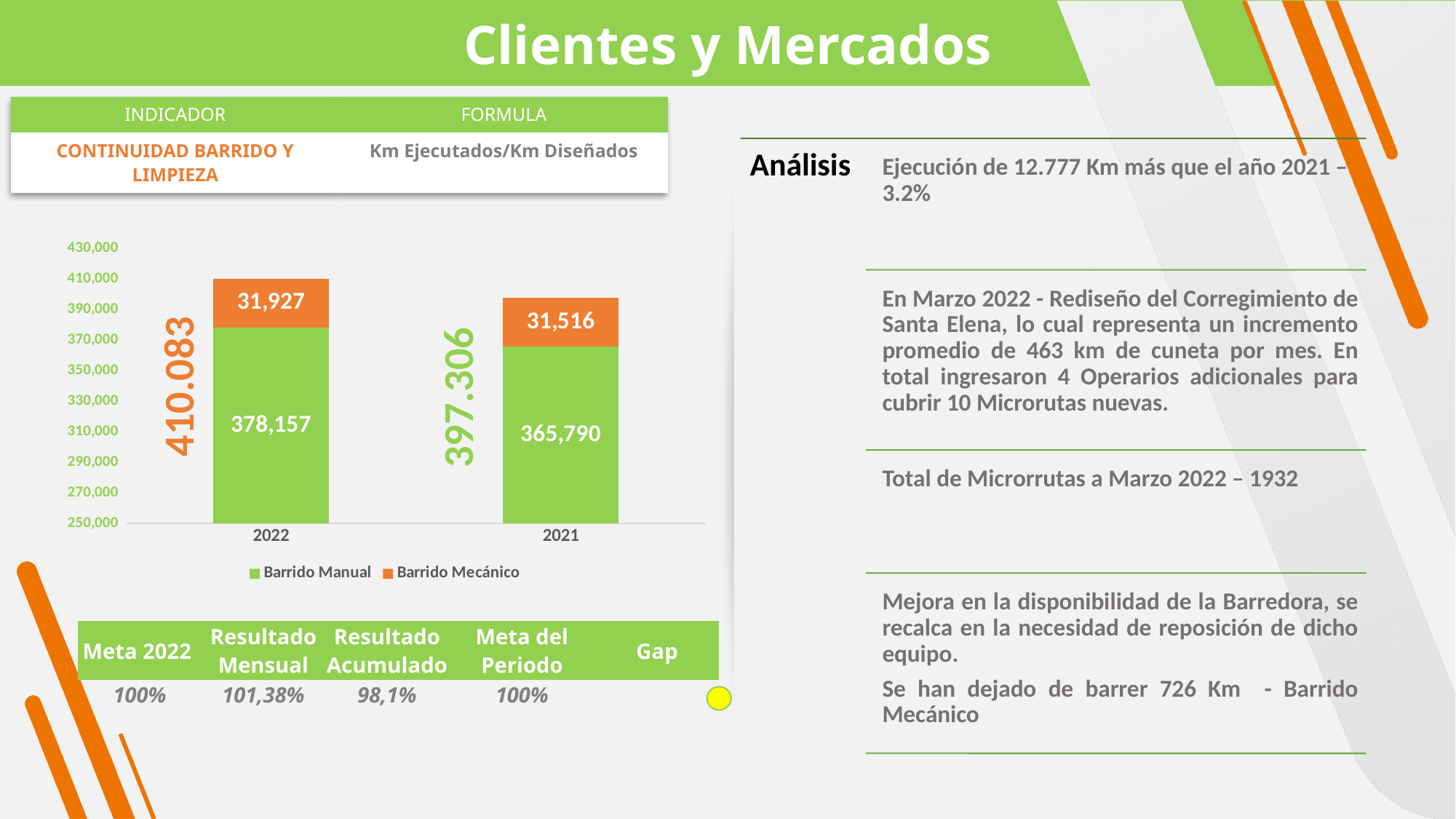
Which year has the higher Barrido Manual value? 2022 What total is printed beside the 2021 stacked bar? 397.306 What is the difference between the Barrido Mecánico values for 2022 and 2021? 411 What is the difference between the Barrido Manual values for 2022 and 2021? 12,367 What is the value for Barrido Mecánico in 2021? 31,516 What is the value for Barrido Manual in 2021? 365,790 How many series does the chart legend list? 2 How many categories are shown on the x axis of the chart? 2 What is the value for Barrido Mecánico in 2022? 31,927 What is the value for Barrido Manual in 2022? 378,157 What total is printed beside the 2022 stacked bar? 410.083 What kind of chart is shown on the slide? Stacked bar chart